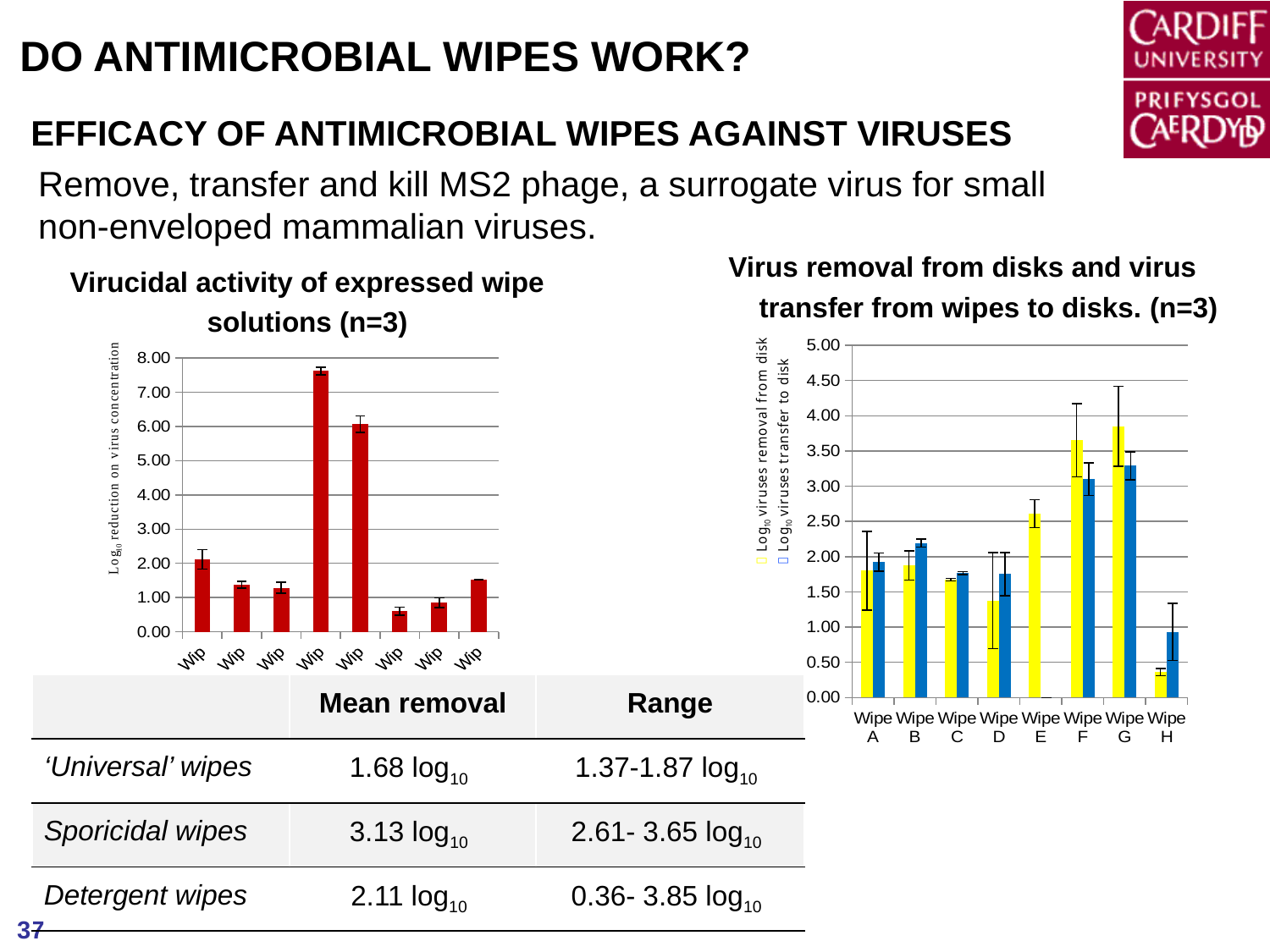
In the 'Virus removal from disks and virus transfer from wipes to disks' chart, which wipe has the highest Log10 viruses removal from disk? Wipe G What kind of chart is the 'Virus removal from disks and virus transfer from wipes to disks' chart? Bar chart In the 'Virus removal from disks and virus transfer from wipes to disks' chart, which has the larger Log10 viruses removal from disk, Wipe A or Wipe F? Wipe F What kind of chart is the 'Virucidal activity of expressed wipe solutions (n=3)' chart? Bar chart How many bars are plotted in the 'Virucidal activity of expressed wipe solutions (n=3)' chart? 8 In the 'Virus removal from disks and virus transfer from wipes to disks' chart, which wipe has the lowest Log10 viruses removal from disk? Wipe H How many series does the legend of the 'Virus removal from disks and virus transfer from wipes to disks' chart list? 2 In the 'Virus removal from disks and virus transfer from wipes to disks' chart, is the Log10 viruses transfer to disk for Wipe D greater or less than 2.00? less In the 'Virus removal from disks and virus transfer from wipes to disks' chart, is the Log10 viruses removal from disk for Wipe H greater or less than 0.50? less In the 'Virus removal from disks and virus transfer from wipes to disks' chart, what colour are the bars for Log10 viruses removal from disk? Yellow How many wipes are shown on the x axis of the 'Virus removal from disks and virus transfer from wipes to disks' chart? 8 In the 'Virus removal from disks and virus transfer from wipes to disks' chart, is the Log10 viruses removal from disk for Wipe F greater or less than 3.00? greater